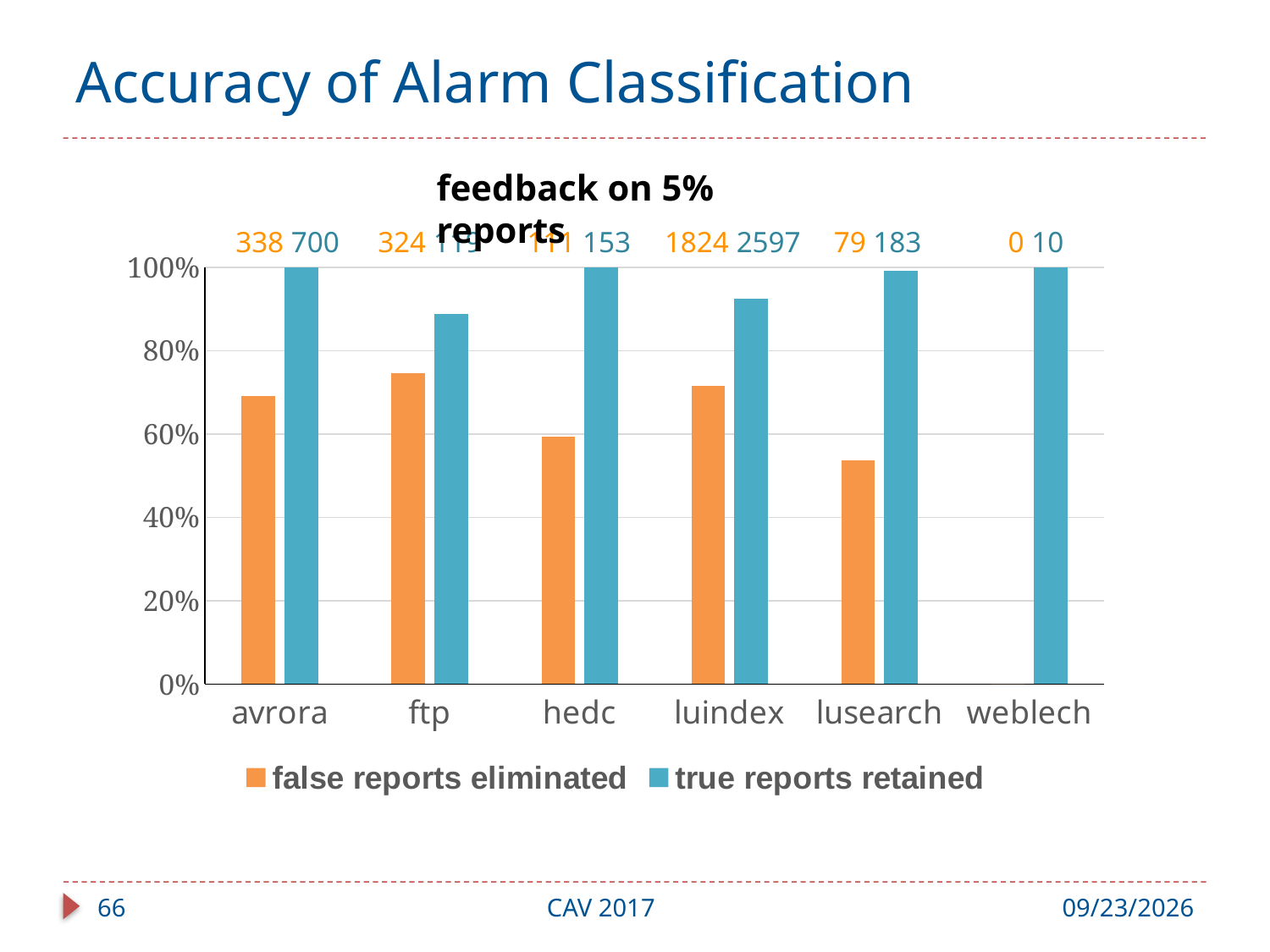
Is the 'false reports eliminated' value for avrora greater or less than 60%? greater Which is larger, the 'false reports eliminated' value for avrora or for hedc? avrora How many categories are shown on the x axis? 6 What numbers are printed above the avrora bars? 338 700 Which category has the lowest 'true reports retained' bar? ftp Which colour represents 'true reports retained' in the legend? blue Is the 'false reports eliminated' value for hedc greater or less than 40%? greater Which is larger, the 'false reports eliminated' value for ftp or for lusearch? ftp Is the 'true reports retained' value for ftp greater or less than 80%? greater What kind of chart is shown on the slide? bar chart How many series does the legend list? 2